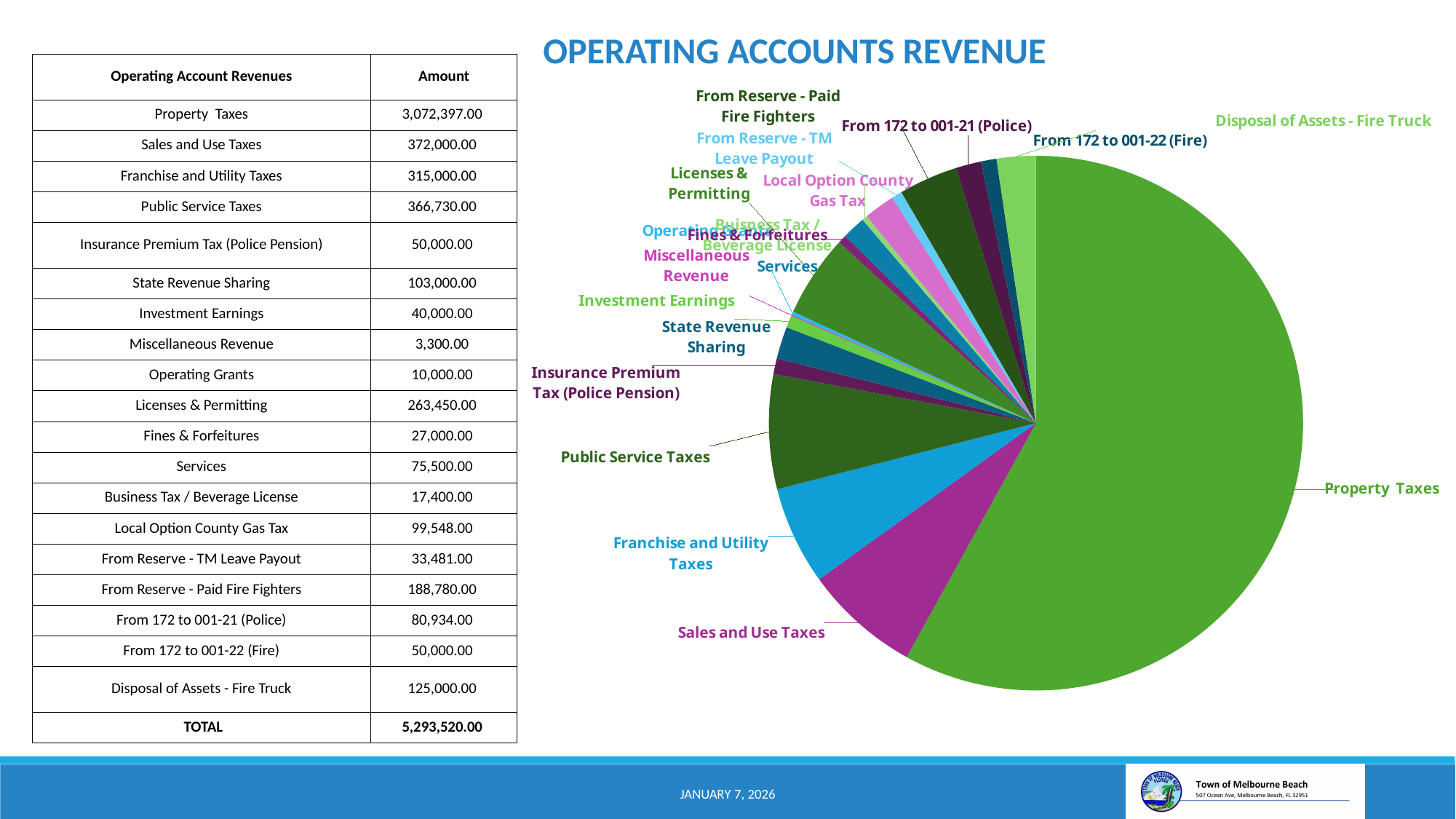
What is the amount for Property Taxes? 3,072,397.00 Which is larger, Public Service Taxes or Licenses & Permitting? Public Service Taxes What is the title of the chart? OPERATING ACCOUNTS REVENUE How many categories are shown in the pie chart? 19 Which category has the smallest amount in the Operating Account Revenues table? Miscellaneous Revenue Which category has the largest slice of the pie? Property Taxes What kind of chart is shown on the slide? pie chart Which is larger, Sales and Use Taxes or Franchise and Utility Taxes? Sales and Use Taxes What is the amount for Local Option County Gas Tax? 99,548.00 What is the difference between Sales and Use Taxes and Franchise and Utility Taxes? 57,000.00 What is the amount for From Reserve - Paid Fire Fighters? 188,780.00 What is the total of all Operating Account Revenues? 5,293,520.00